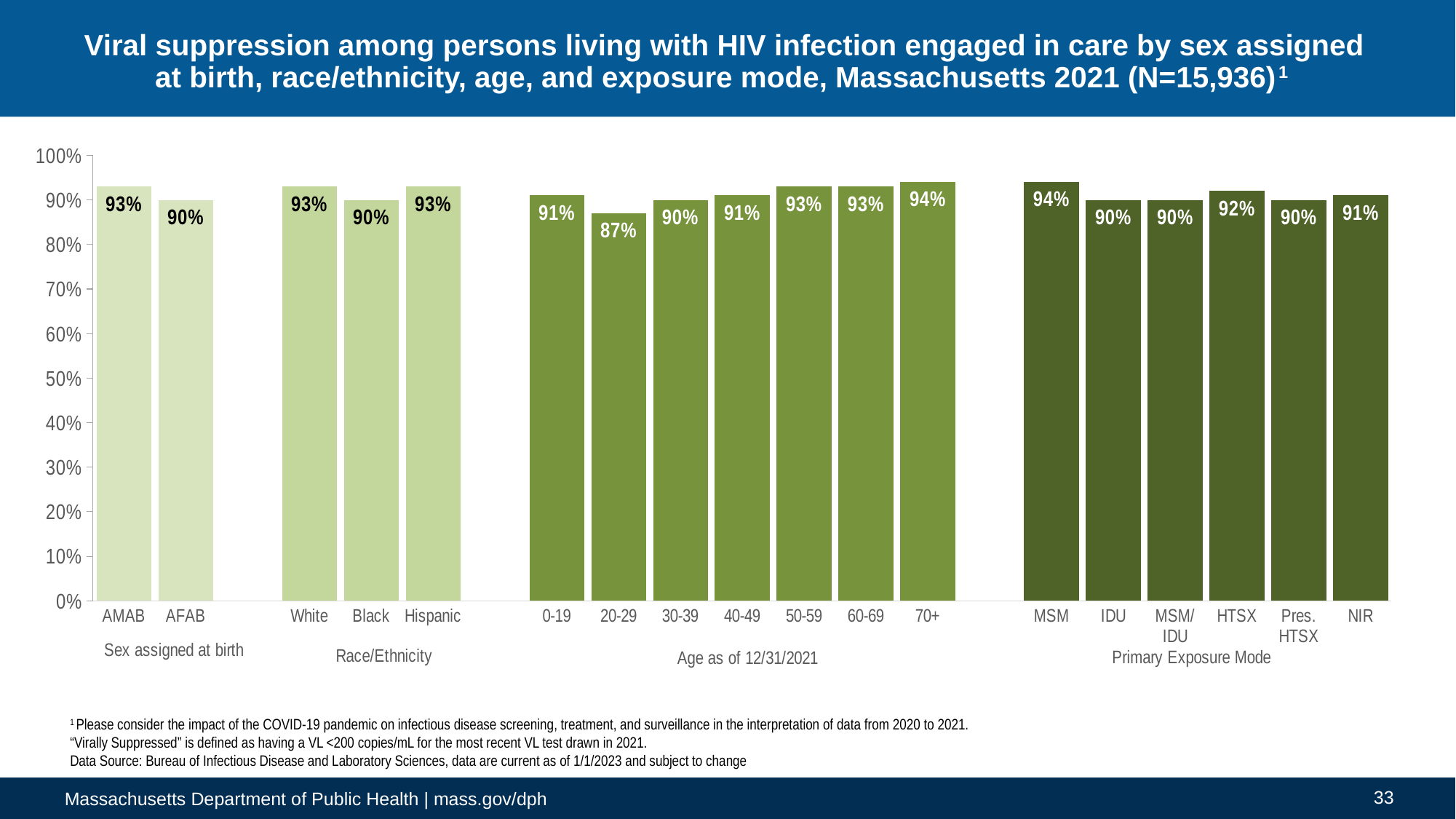
Which has a higher viral suppression percentage, White or Black? White How many primary exposure mode categories are shown in the chart? 6 What kind of chart is shown on the slide? Bar chart Which age group has the lowest viral suppression percentage? 20-29 What is the viral suppression percentage for AMAB? 93% What is the viral suppression percentage for the 20-29 age group? 87% What is the difference in viral suppression between the 70+ and 20-29 age groups? 7% What is the viral suppression percentage for HTSX under Primary Exposure Mode? 92% What is the label of the group containing the AMAB and AFAB bars? Sex assigned at birth How many age groups are shown in the chart? 7 What is the difference in viral suppression between AMAB and AFAB? 3% Which primary exposure mode has the highest viral suppression percentage? MSM